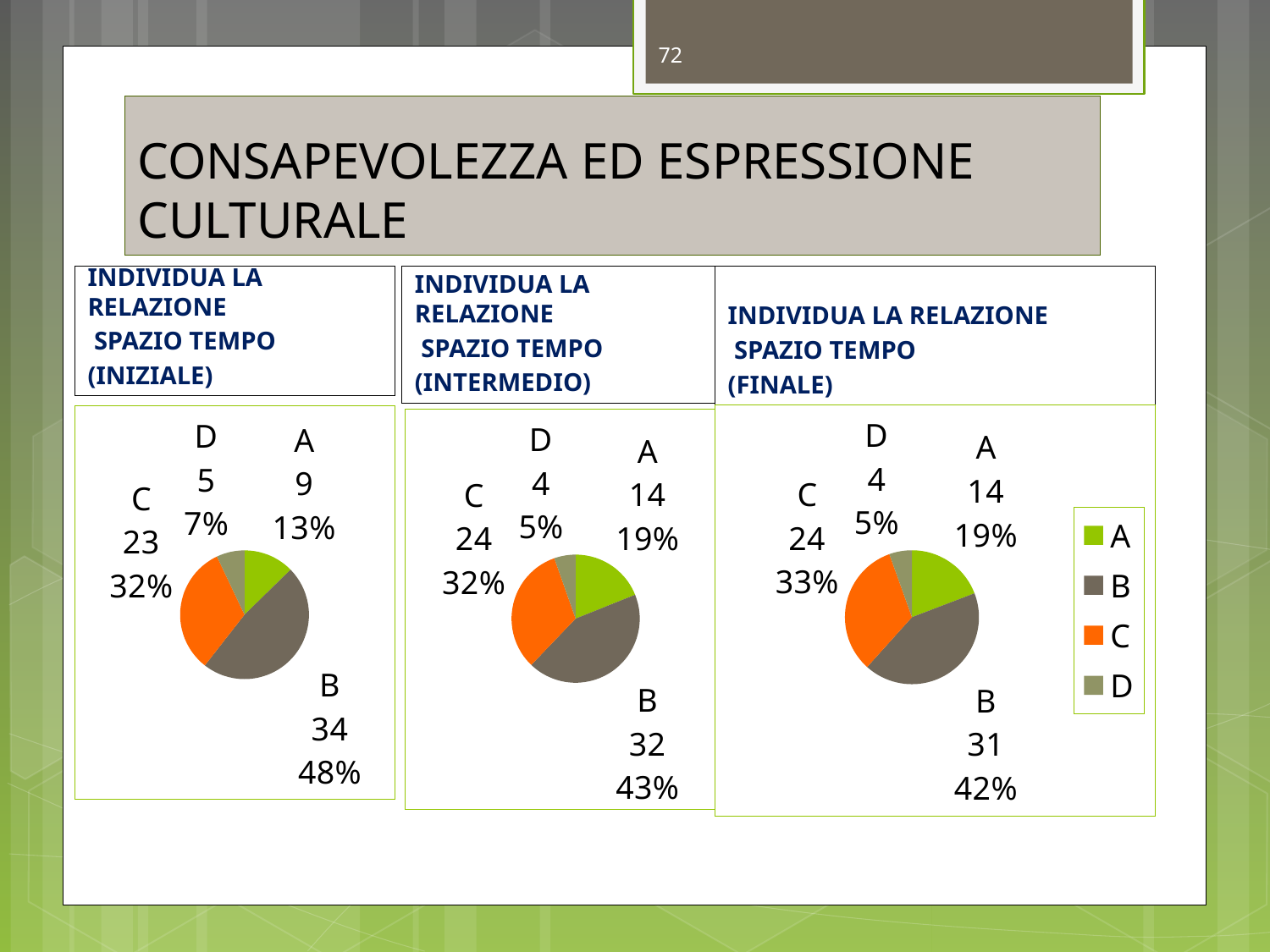
In the FINALE pie chart, which is larger, the count for A or the count for C? C What type of chart is used for the INIZIALE data? Pie chart In the FINALE pie chart, which category has the smallest slice? D In the INTERMEDIO pie chart, what is the count for category A? 14 How many entries does the legend on the right of the slide list? 4 In the FINALE pie chart, what percentage share does category B have? 42% In the INIZIALE pie chart, what percentage share does category C have? 32% In the INIZIALE pie chart, what is the count for category B? 34 In the INIZIALE pie chart, which category has the largest slice? B In the INTERMEDIO pie chart, what is the difference between the counts for B and C? 8 In the legend, which colour represents category C? Orange How many categories does the INTERMEDIO pie chart show? 4